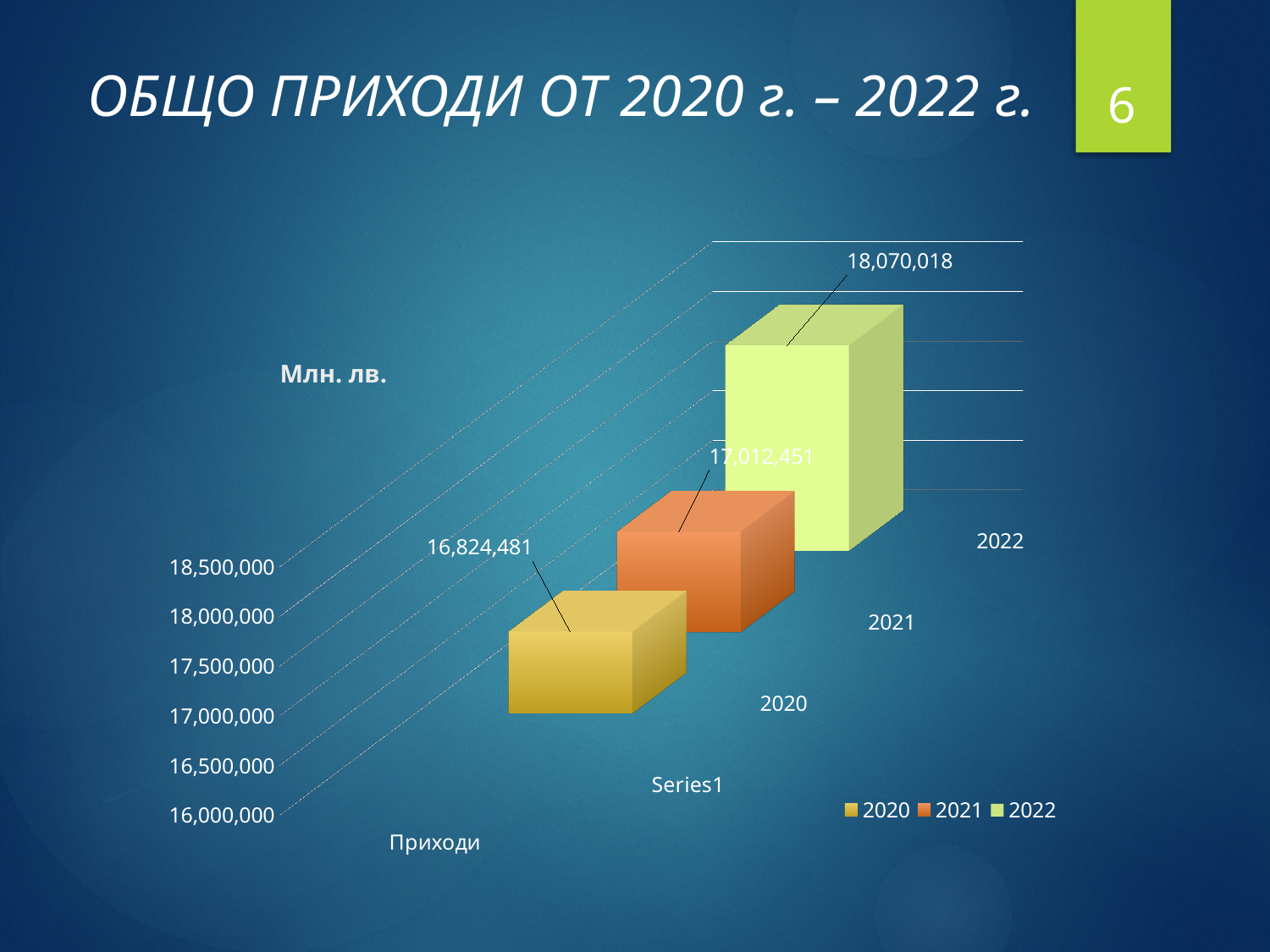
Is the value for 2022 greater or less than 18,000,000? greater Which is larger, the value for 2021 or the value for 2020? 2021 Which year has the highest value? 2022 What is the difference between the values for 2022 and 2021? 1,057,567 Do the values rise or fall from 2020 to 2022? rise Which year has the lowest value? 2020 What is the value for 2022? 18,070,018 What is the value for 2020? 16,824,481 What is the difference between the values for 2021 and 2020? 187,970 How many series does the legend list? 3 What kind of chart is shown on the slide? bar chart What is the value for 2021? 17,012,451